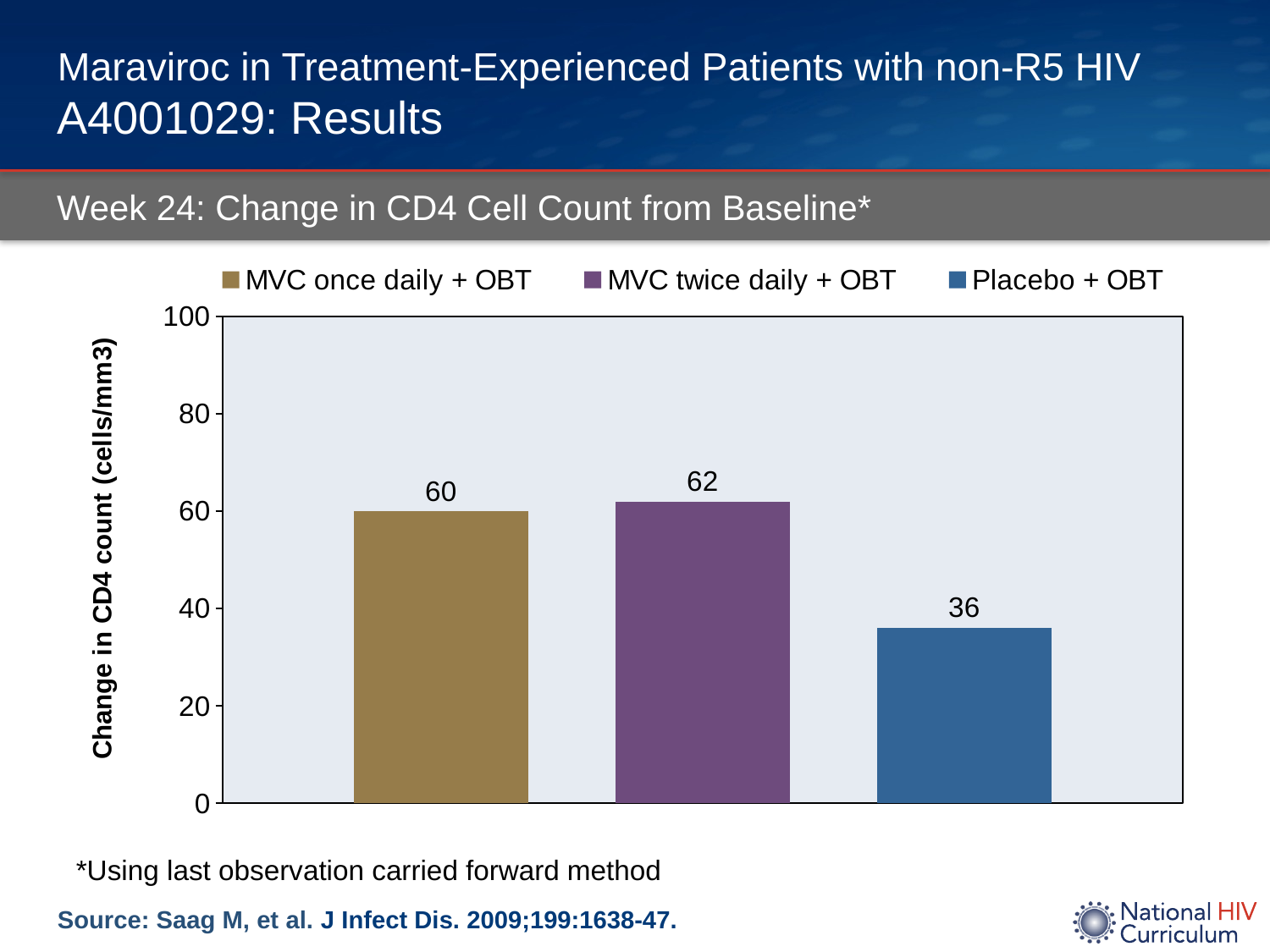
Which is larger, the change in CD4 count for MVC once daily + OBT or for Placebo + OBT? MVC once daily + OBT How many bars are shown in the chart? 3 What is the change in CD4 count for MVC once daily + OBT? 60 What is the difference in CD4 count change between MVC twice daily + OBT and Placebo + OBT? 26 How many series does the legend list? 3 What is the change in CD4 count for MVC twice daily + OBT? 62 Is the value for Placebo + OBT greater or less than 40? less What is the change in CD4 count for Placebo + OBT? 36 What is the difference in CD4 count change between MVC once daily + OBT and Placebo + OBT? 24 Which group has the lowest change in CD4 count? Placebo + OBT What is the label of the y axis? Change in CD4 count (cells/mm3) What kind of chart is shown on the slide? bar chart